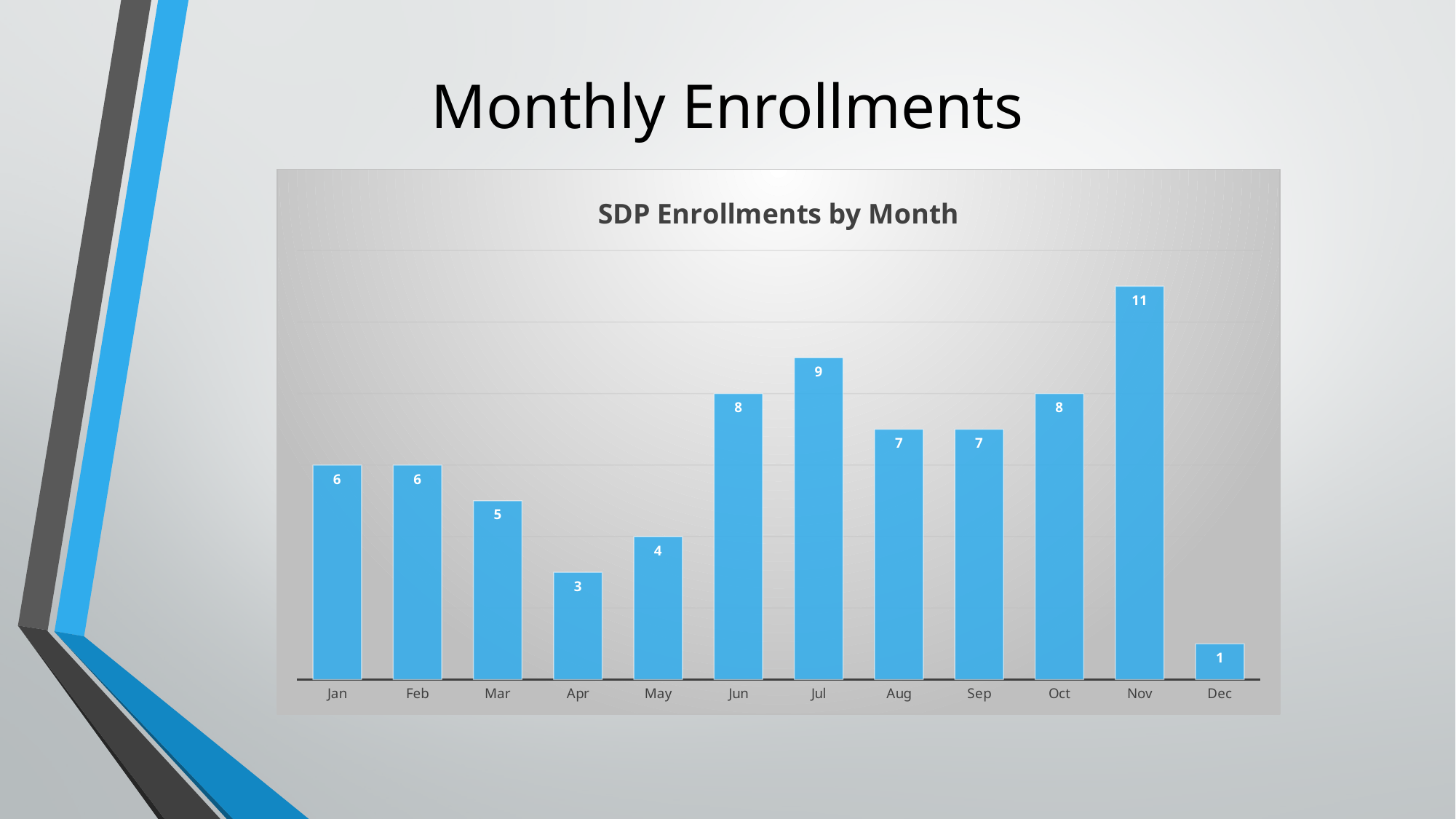
What kind of chart is the SDP Enrollments by Month chart? Bar chart Do the values rise or fall from Mar to Apr in the SDP Enrollments by Month chart? Fall Which month has the lowest value in the SDP Enrollments by Month chart? Dec What is the value for Apr in the SDP Enrollments by Month chart? 3 What is the value for Jul in the SDP Enrollments by Month chart? 9 How many months are shown on the x axis of the SDP Enrollments by Month chart? 12 Which is larger in the SDP Enrollments by Month chart, the value for Jun or the value for May? Jun What is the difference between the values for Nov and Dec in the SDP Enrollments by Month chart? 10 Which month has the highest value in the SDP Enrollments by Month chart? Nov What is the title of the chart on the slide? SDP Enrollments by Month What is the difference between the values for Jul and Mar in the SDP Enrollments by Month chart? 4 What is the value for Nov in the SDP Enrollments by Month chart? 11